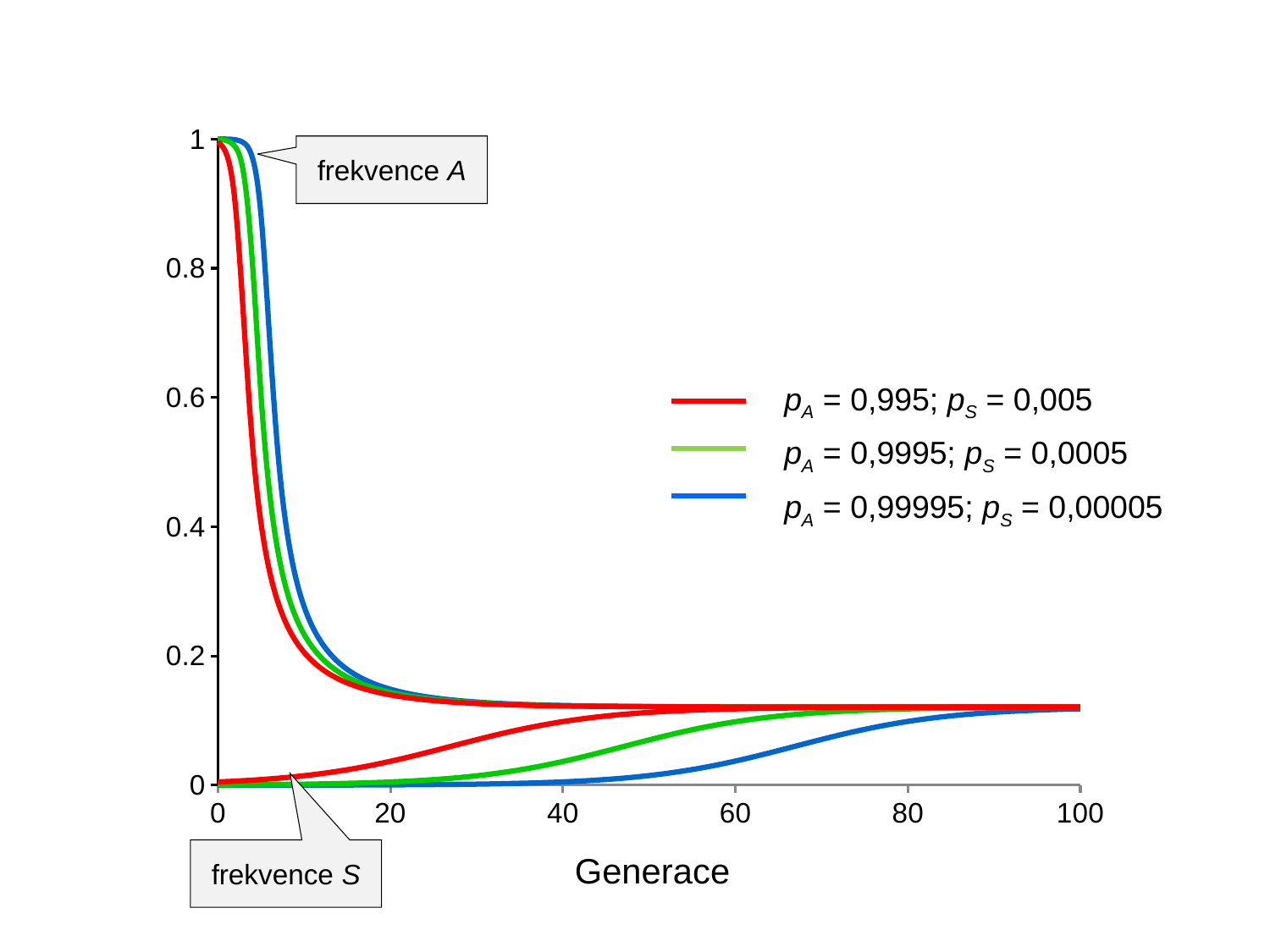
What is the label of the x axis? Generace What is the value of 'frekvence S' at generation 0? 0 At generation 60, which 'frekvence S' curve is higher, the red one or the blue one? red At generation 10, which 'frekvence A' curve is higher, the red one or the blue one? blue Do the 'frekvence S' curves rise or fall as the generation number increases? rise How many series does the legend list? 3 What is the legend entry for the blue series? p_A = 0,99995; p_S = 0,00005 What kind of chart is shown on the slide? line chart Is the blue 'frekvence S' curve at generation 40 greater or less than 0.2? less What is the value of 'frekvence A' at generation 0? 1 Do the 'frekvence A' curves rise or fall as the generation number increases? fall Is the red 'frekvence A' curve at generation 20 greater or less than 0.2? less